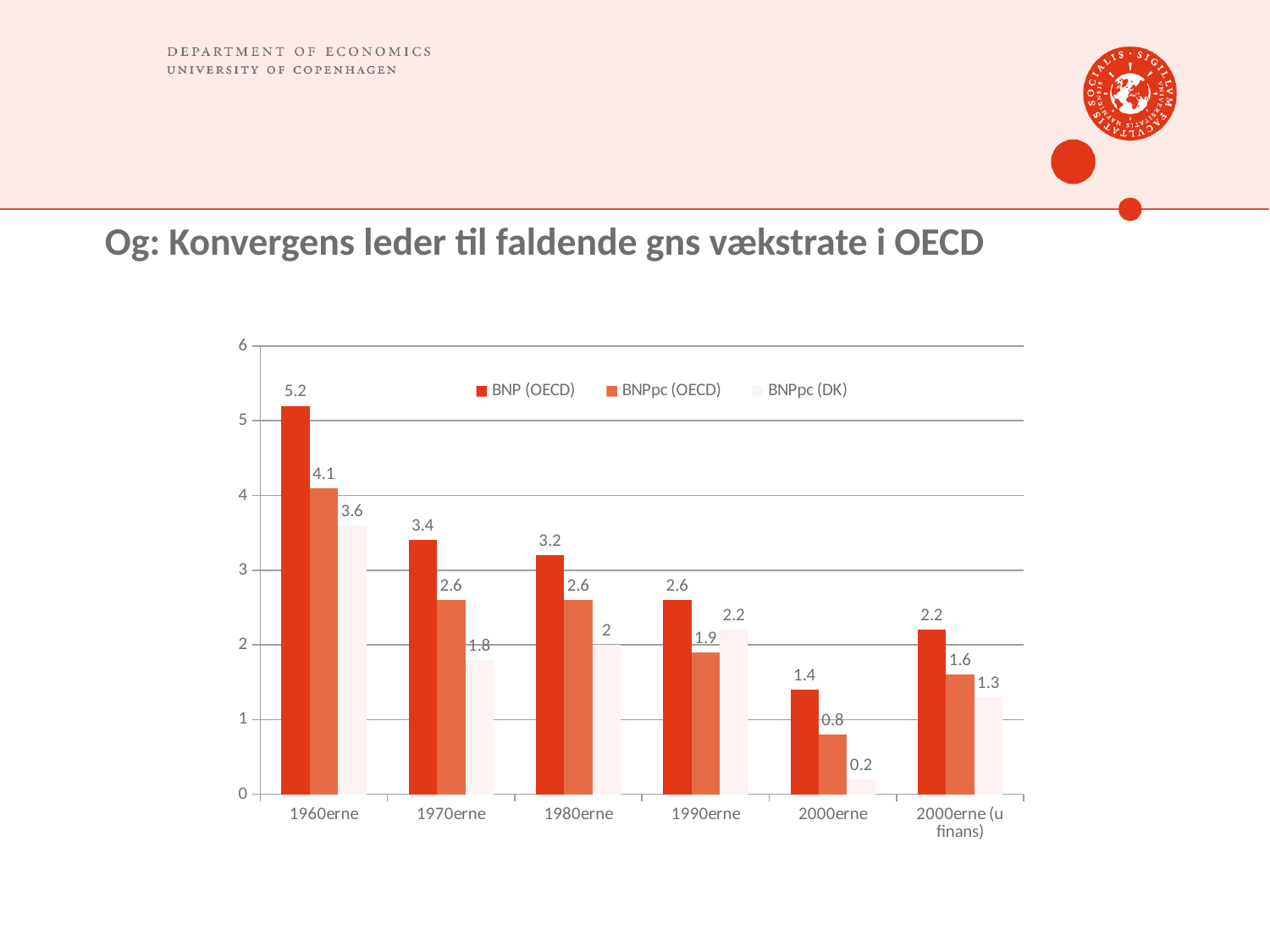
What kind of chart is shown on the slide? Bar chart What is the value of BNP (OECD) for 1960erne? 5.2 Does the BNP (OECD) value rise or fall from 1960erne to 2000erne? Fall What is the value of BNPpc (DK) for 2000erne? 0.2 What is the value of BNPpc (OECD) for 1990erne? 1.9 How many series does the legend list? 3 What is the difference between BNP (OECD) and BNPpc (OECD) for 1960erne? 1.1 How many decade categories are shown on the x axis? 6 Which is larger for 1990erne: BNPpc (OECD) or BNPpc (DK)? BNPpc (DK) What is the title of the slide? Og: Konvergens leder til faldende gns vækstrate i OECD Which decade has the lowest BNPpc (DK) value? 2000erne Which decade has the highest BNP (OECD) value? 1960erne